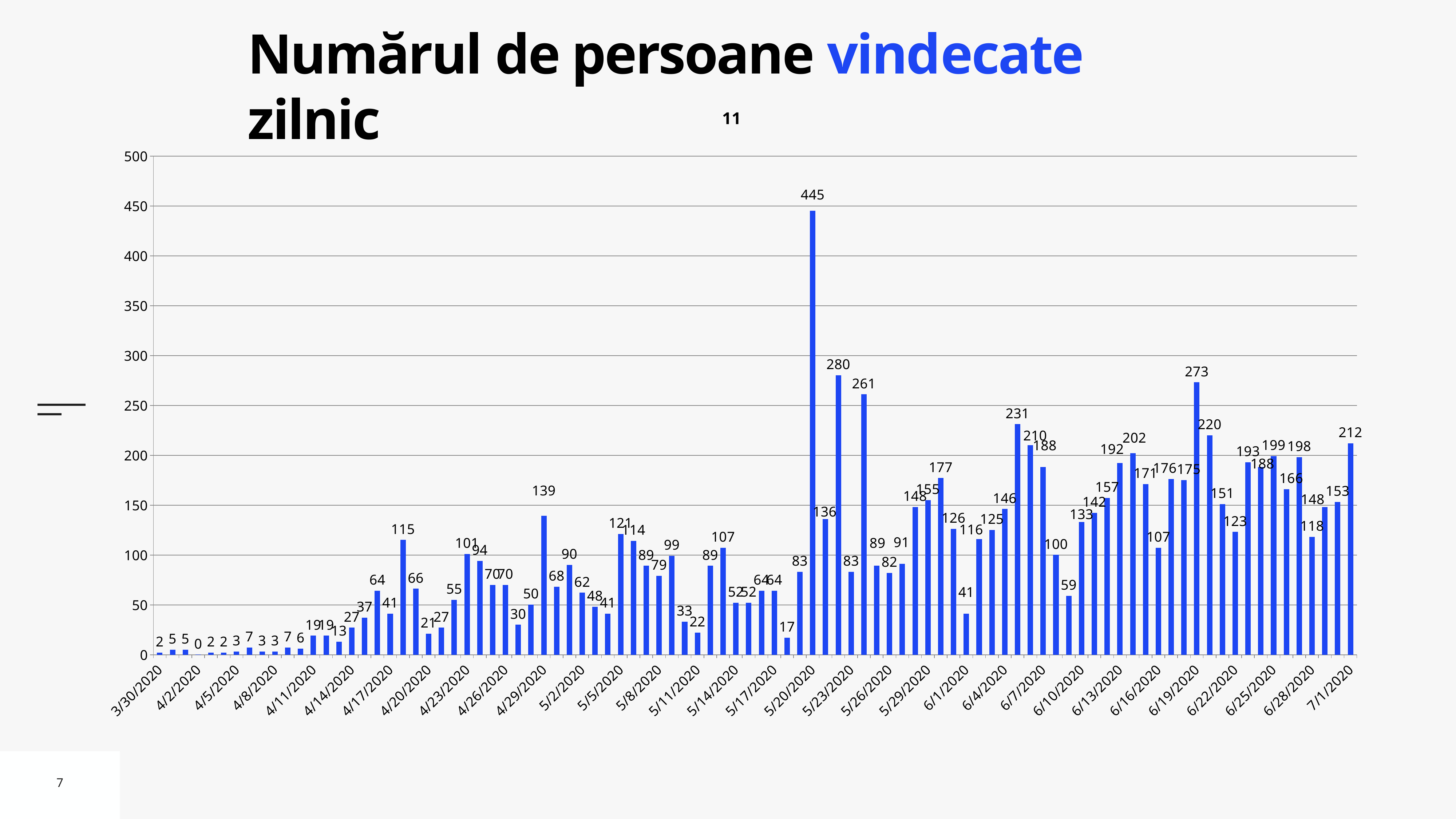
What kind of chart is shown on the slide? bar chart What is the value for 5/5/2020? 121 What is the difference between the values for 6/19/2020 and 7/1/2020? 61 Which is larger, the value for 6/1/2020 or the value for 6/4/2020? 6/4/2020 What is the value for 5/20/2020? 445 Is the value for 6/13/2020 greater or less than 150? greater What is the title of the chart on the slide? 11 Overall, do the values rise or fall from 3/30/2020 to 7/1/2020? rise What is the value for 6/19/2020? 273 What is the value for 7/1/2020? 212 What is the value for 4/2/2020? 0 Which date has the highest number of recovered persons? 5/20/2020